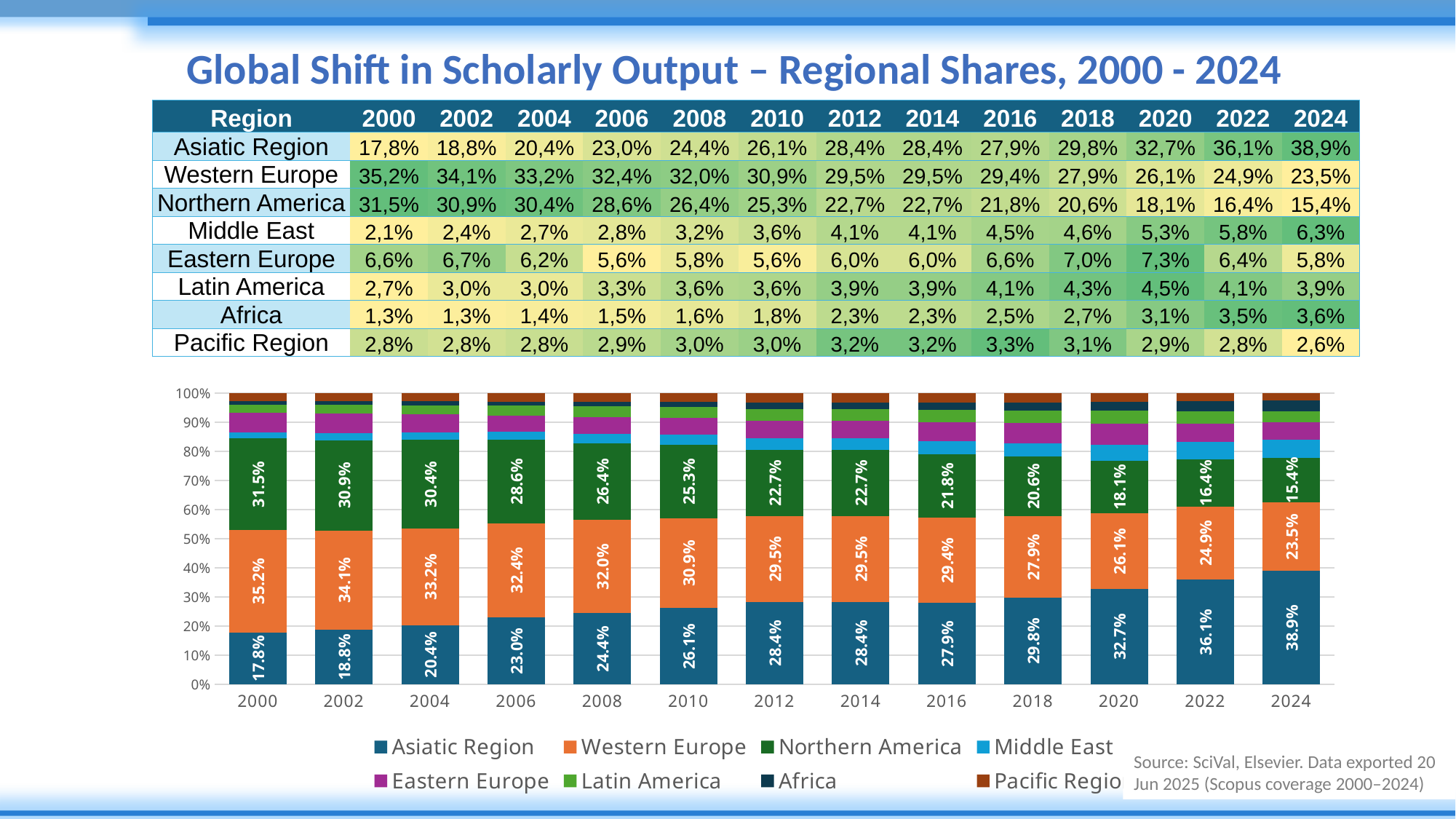
What is the value labelled for the Asiatic Region in 2024 in the chart? 38.9% Which colour represents Western Europe in the chart legend? orange Does the Asiatic Region's share rise or fall from 2000 to 2024 in the chart? rise What is the value labelled for Western Europe in 2000 in the chart? 35.2% What is the value labelled for Northern America in 2012 in the chart? 22.7% What type of chart is shown on the slide? stacked bar chart In which year is the Asiatic Region's labelled share highest in the chart? 2024 In which year is Northern America's labelled share lowest in the chart? 2024 What is the difference between the Asiatic Region's share in 2024 and in 2000 according to the chart labels? 21.1% In 2000, which has the larger labelled share in the chart: Western Europe or Northern America? Western Europe How many years are shown along the x axis of the chart? 13 How many series does the chart legend list? 8